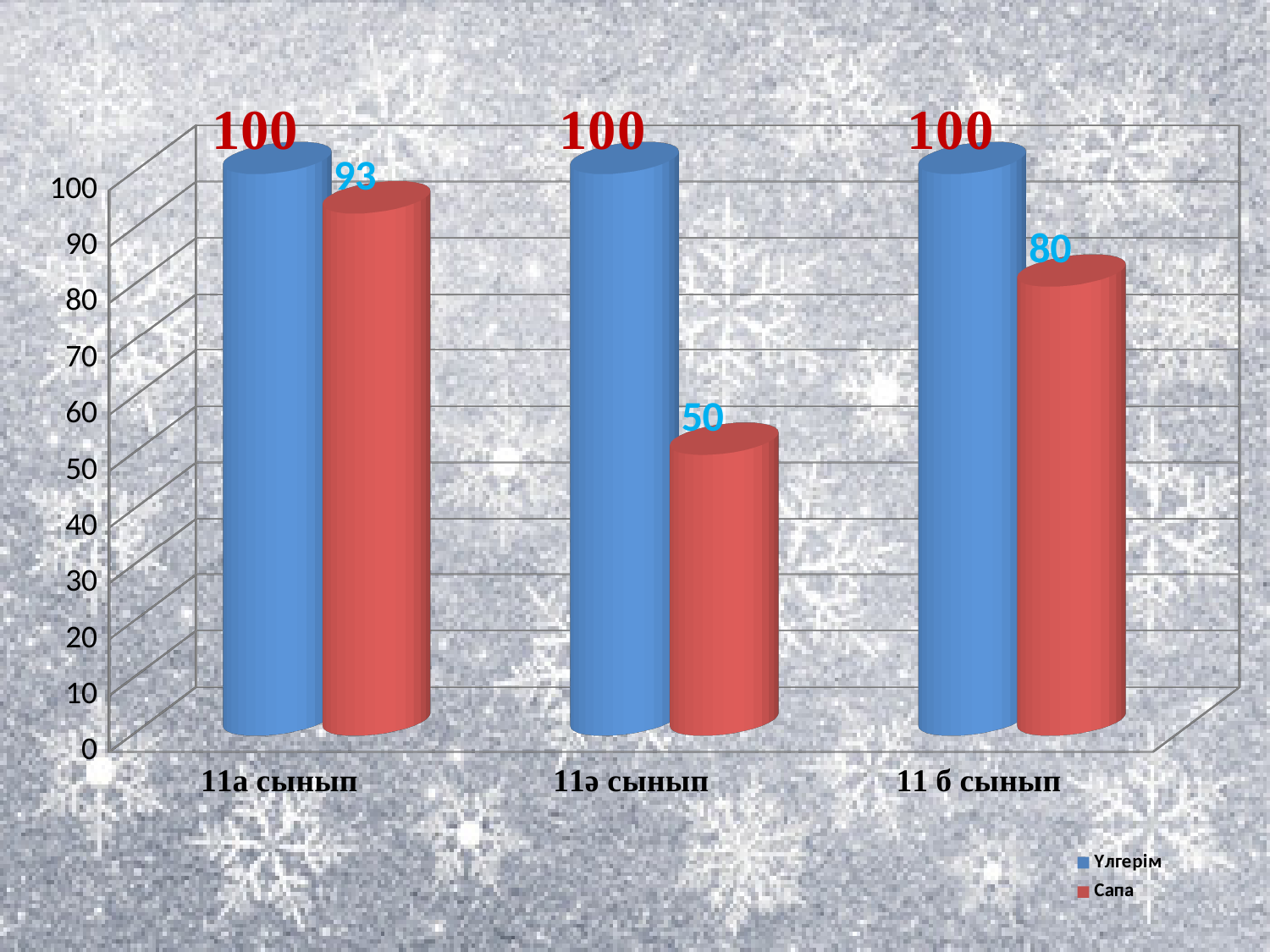
What is the Сапа value for 11 б сынып? 80 How many classes are shown on the x axis? 3 What is the difference between the Үлгерім and Сапа values for 11ә сынып? 50 What is the Сапа value for 11а сынып? 93 What is the Үлгерім value for 11ә сынып? 100 Which is larger, the Сапа value for 11 б сынып or for 11ә сынып? 11 б сынып What is the difference between the Сапа values for 11а сынып and 11 б сынып? 13 Which class has the highest Сапа value? 11а сынып What is the Сапа value for 11ә сынып? 50 Which class has the lowest Сапа value? 11ә сынып What kind of chart is shown on the slide? Bar chart How many series does the legend list? 2